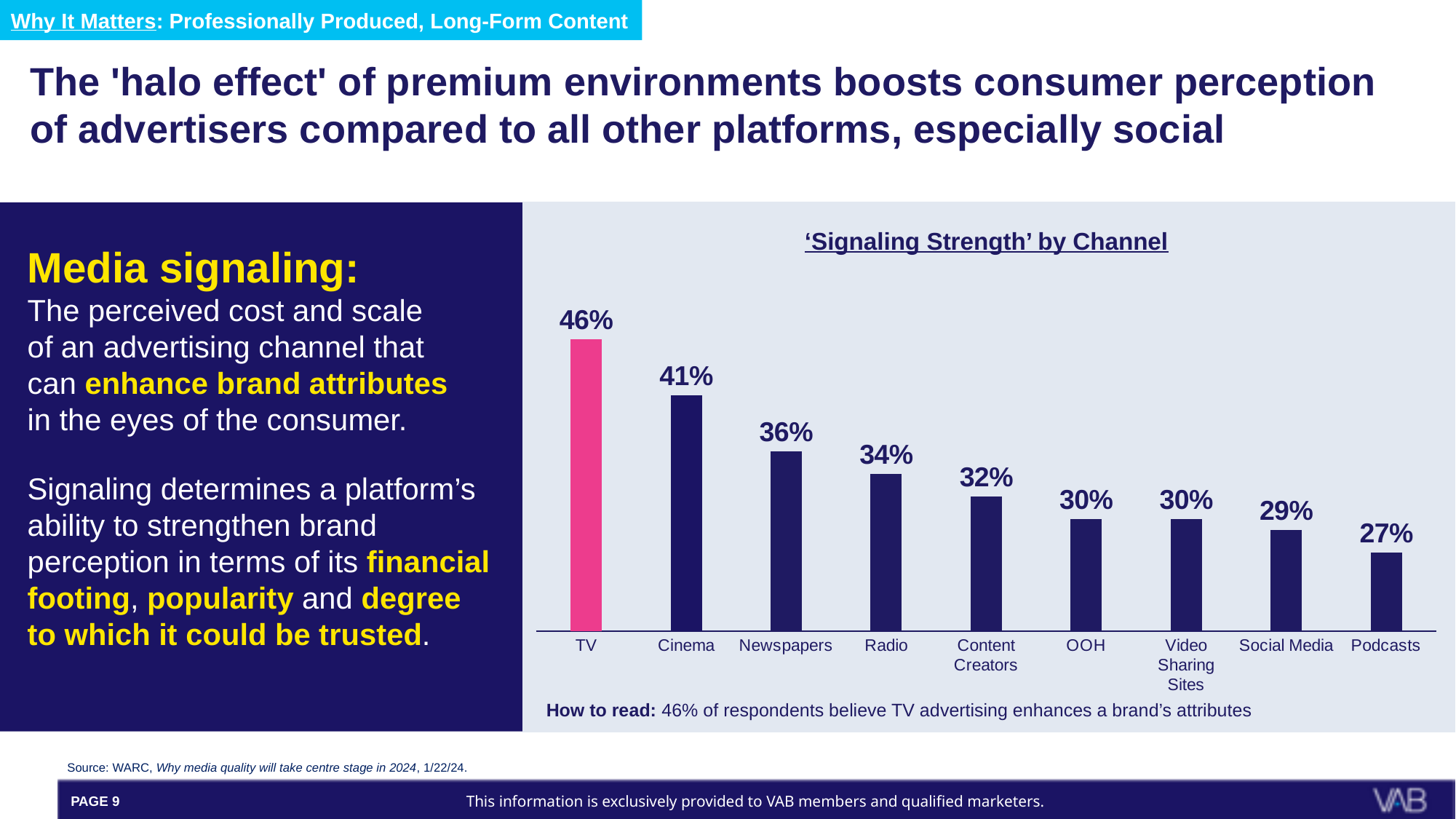
What is the signaling strength value for Podcasts? 27% Which bar in the chart is highlighted in pink? TV What type of chart is used to show 'Signaling Strength' by Channel? Bar chart What is the signaling strength value for Cinema? 41% What is the signaling strength value for Content Creators? 32% How many channels are shown in the chart? 9 Which channel has the lowest signaling strength? Podcasts Which channel has the highest signaling strength? TV What is the difference between the signaling strength of TV and Social Media? 17% What is the signaling strength value for TV? 46% What is the difference between the signaling strength of Cinema and Newspapers? 5% Which has a higher signaling strength, Radio or OOH? Radio